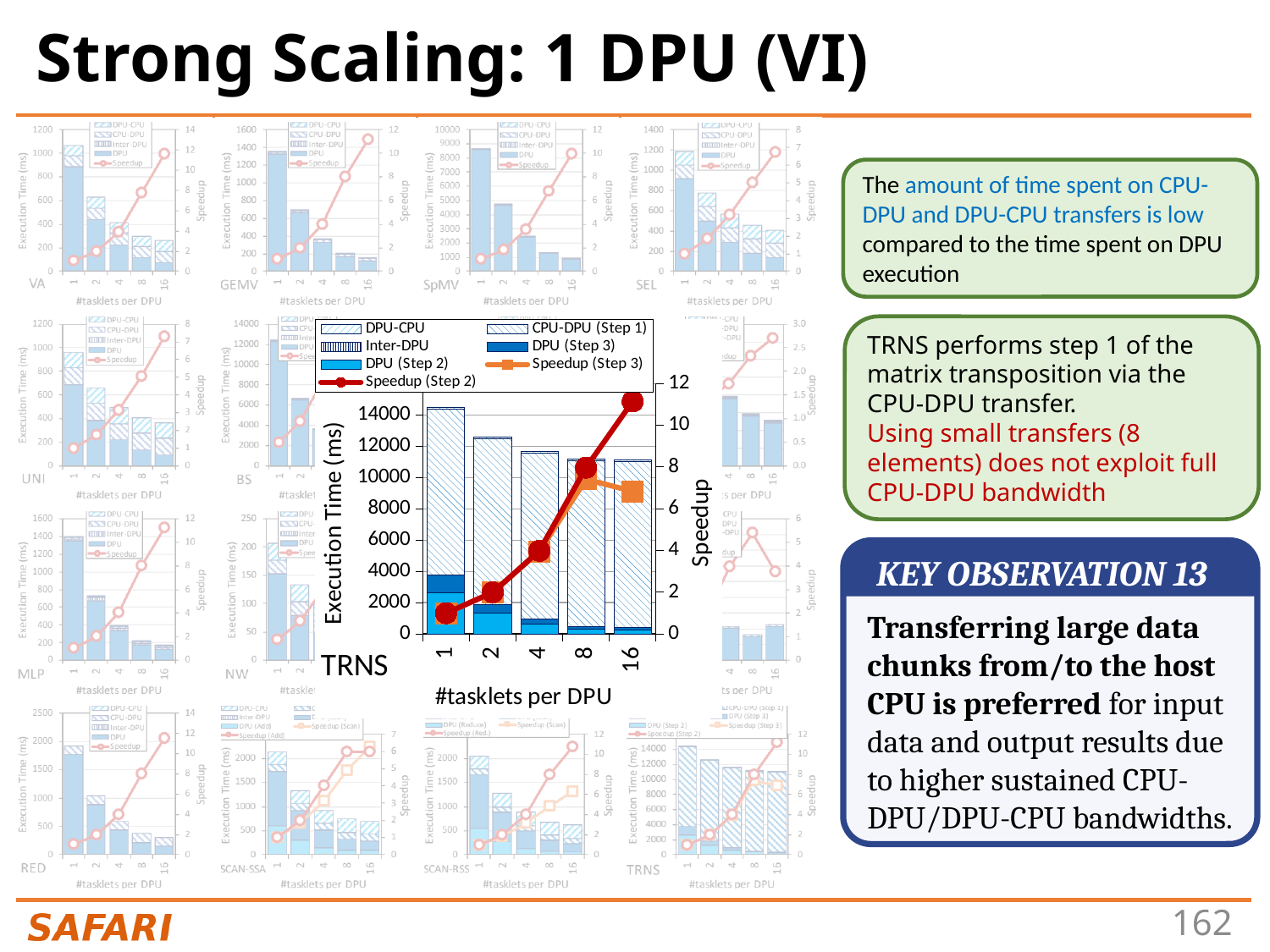
In the TRNS chart, at 16 tasklets per DPU, which is larger: Speedup (Step 2) or Speedup (Step 3)? Speedup (Step 2) In the TRNS chart, is the Speedup (Step 2) value for 16 tasklets per DPU greater or less than 10? greater In the TRNS chart, is the Speedup (Step 3) value for 16 tasklets per DPU greater or less than 8? less In the TRNS chart, is the total execution time for 2 tasklets per DPU greater or less than 12000? greater In the TRNS chart, which number of tasklets per DPU has the highest total execution time? 1 In the TRNS chart, how many #tasklets per DPU categories are shown on the x axis? 5 What kind of chart is the large TRNS chart in the centre of the slide? bar chart with line series overlaid What is the label of the x axis of the TRNS chart? #tasklets per DPU In the TRNS chart, does the Speedup (Step 2) line rise or fall as the number of tasklets per DPU increases? rise How many series does the legend of the TRNS chart list? 7